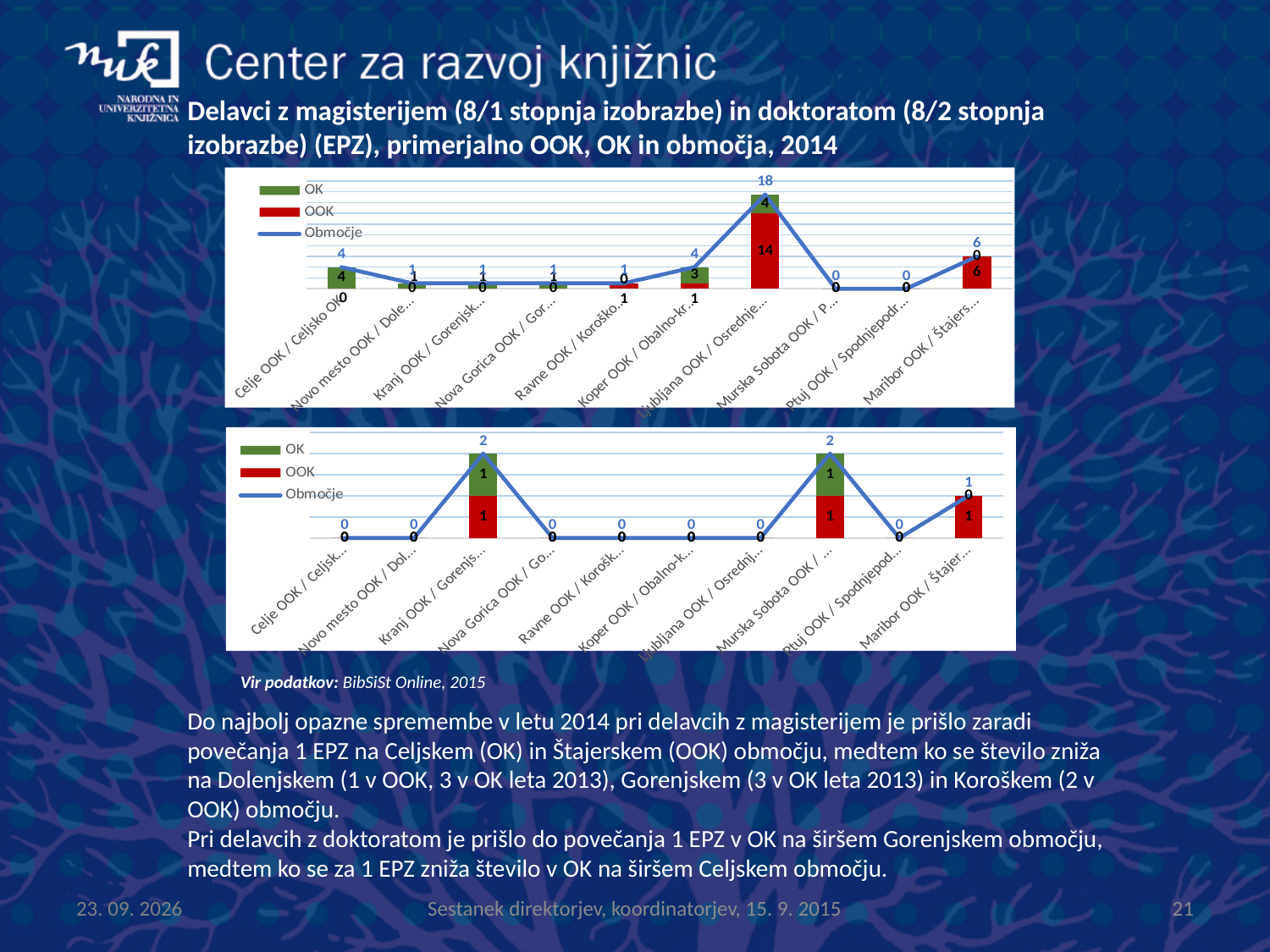
How many series does the legend of the top chart list? 3 In the top chart, which is larger, the OK value for Koper OOK or the OK value for Celje OOK? Celje OOK In the bottom chart, what is the total of the stacked bar for Murska Sobota OOK (OK plus OOK)? 2 In the bottom chart, what is the Območje value for Kranj OOK? 2 In the top chart, what is the OOK value for Ljubljana OOK? 14 What kind of chart is the bottom chart? A combined stacked bar and line chart In the top chart, what is the OK value for Celje OOK? 4 In the bottom chart, what is the OOK value for Maribor OOK? 1 How many categories are shown on the x axis of the bottom chart? 10 In the top chart, what is the difference between the OOK values for Ljubljana OOK and Maribor OOK? 8 In the top chart, what is the Območje value for Ljubljana OOK? 18 In the top chart, which category has the highest Območje value? Ljubljana OOK